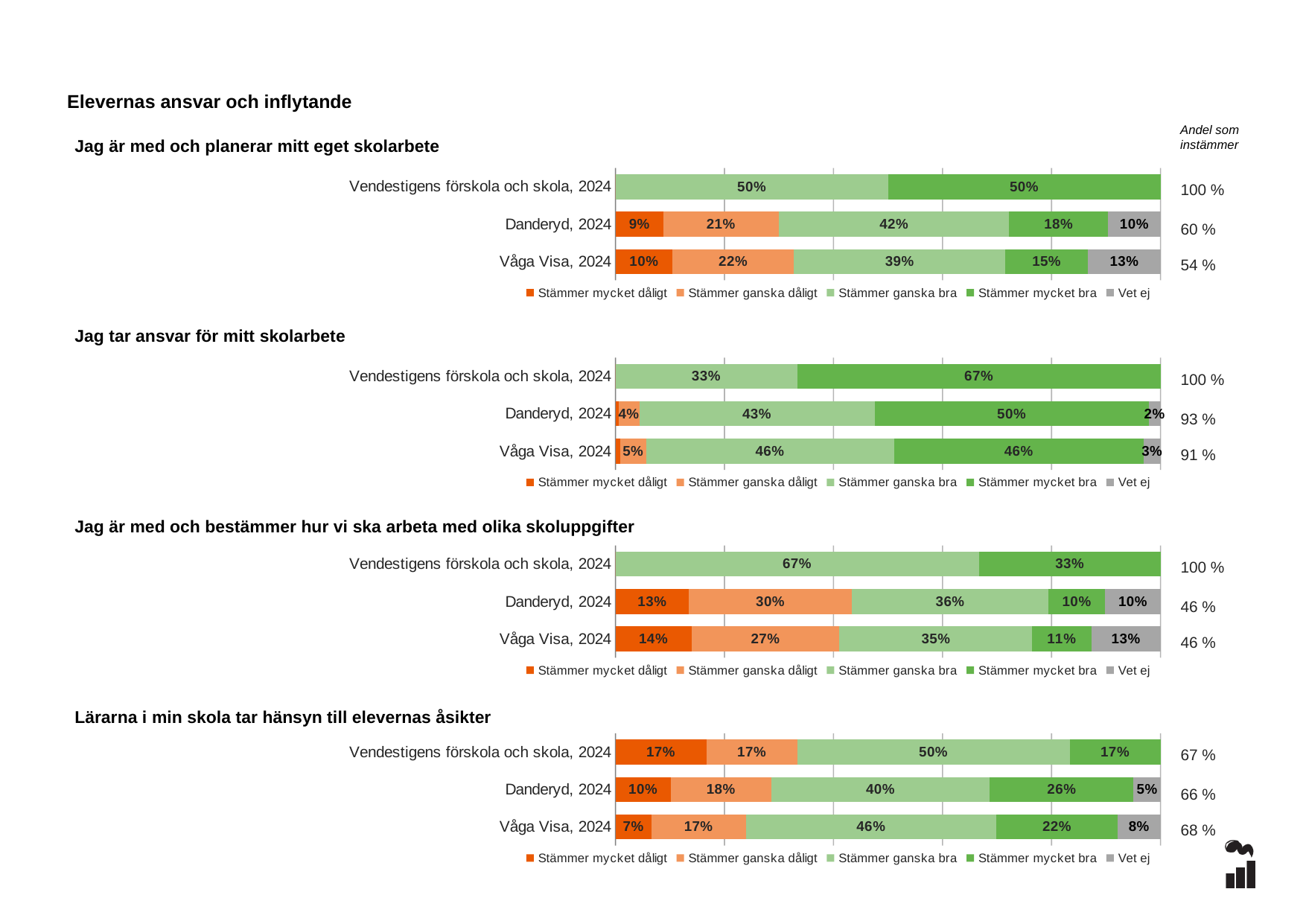
What kind of chart is 'Jag är med och planerar mitt eget skolarbete'? Stacked bar chart In the chart 'Jag tar ansvar för mitt skolarbete', what is the difference between the 'Stämmer ganska bra' values for Våga Visa, 2024 and Danderyd, 2024? 3 percentage points How many categories (bars) does the chart 'Jag är med och bestämmer hur vi ska arbeta med olika skoluppgifter' show? 3 In the chart 'Lärarna i min skola tar hänsyn till elevernas åsikter', which is larger: the 'Stämmer mycket bra' value for Danderyd, 2024 or for Våga Visa, 2024? Danderyd, 2024 In the chart 'Jag är med och planerar mitt eget skolarbete', which category has the lowest 'Stämmer mycket bra' value? Våga Visa, 2024 In the chart 'Jag tar ansvar för mitt skolarbete', what is the 'Stämmer mycket bra' value for Vendestigens förskola och skola, 2024? 67% In the chart 'Jag är med och planerar mitt eget skolarbete', what is the 'Stämmer ganska bra' value for Danderyd, 2024? 42% In the chart 'Lärarna i min skola tar hänsyn till elevernas åsikter', which category has the highest 'Stämmer mycket dåligt' value? Vendestigens förskola och skola, 2024 How many series does the legend of the chart 'Jag tar ansvar för mitt skolarbete' list? 5 In the chart 'Jag är med och bestämmer hur vi ska arbeta med olika skoluppgifter', what is the 'Andel som instämmer' value for Danderyd, 2024? 46 % In the chart 'Lärarna i min skola tar hänsyn till elevernas åsikter', what is the 'Vet ej' value for Våga Visa, 2024? 8% In the legend of the chart 'Jag är med och planerar mitt eget skolarbete', which colour represents 'Vet ej'? Grey